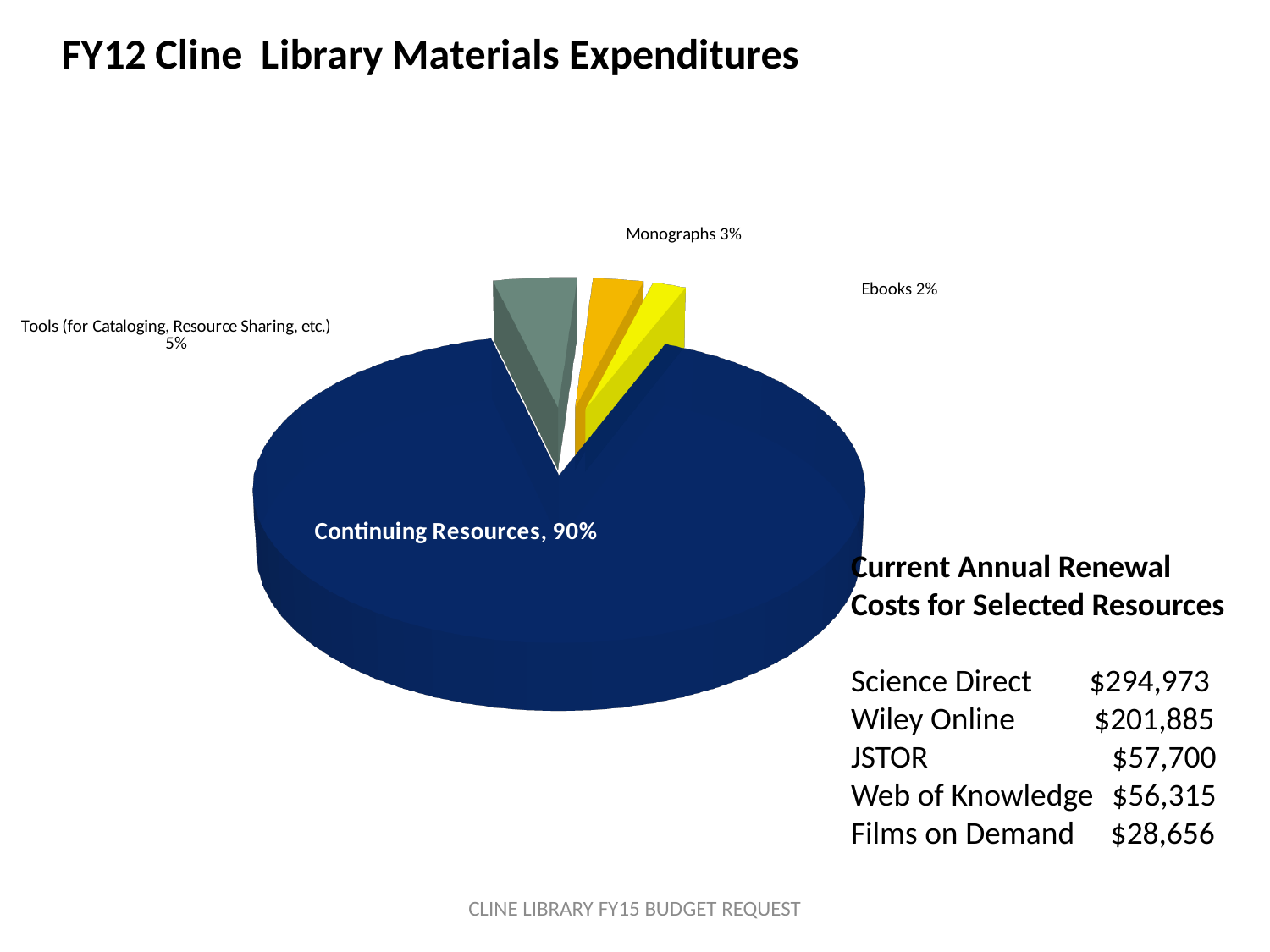
Which slice of the pie is the largest? Continuing Resources What kind of chart is shown on the slide? pie chart Which slice of the pie is the smallest? Ebooks How many slices does the pie chart have? 4 What share of the pie does Tools (for Cataloging, Resource Sharing, etc.) represent? 5% What colour is the Continuing Resources slice? dark blue What is the difference in percentage points between the Tools slice and the Ebooks slice? 3 What share of the pie does Continuing Resources represent? 90% What is the title of the chart? FY12 Cline Library Materials Expenditures What share of the pie does Monographs represent? 3% Which is larger, the Monographs slice or the Ebooks slice? Monographs